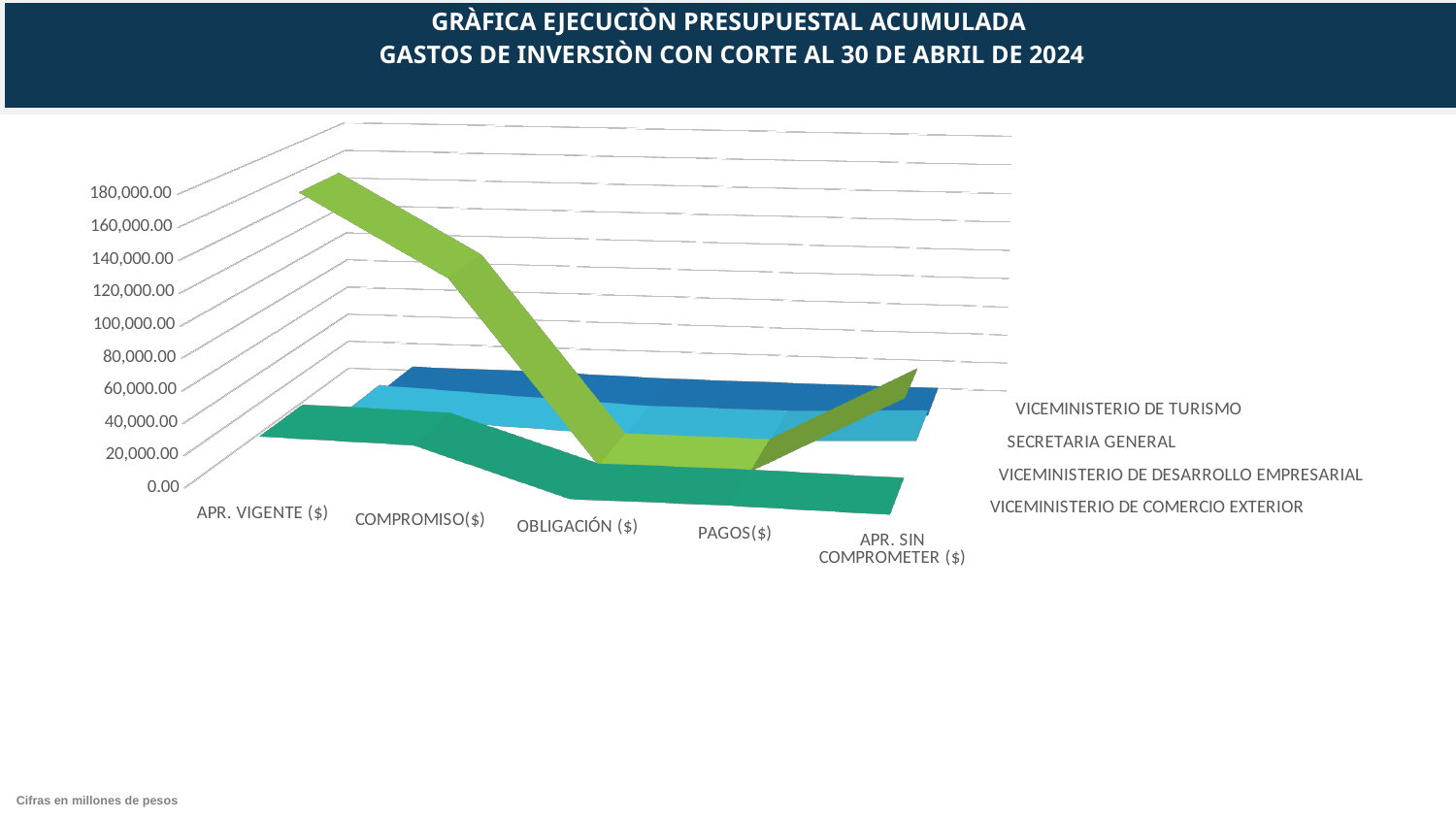
Which category is listed first on the x axis of the chart? APR. VIGENTE ($) Which series has the highest value at APR. VIGENTE ($)? VICEMINISTERIO DE DESARROLLO EMPRESARIAL How many categories are shown along the x axis of the chart? 5 How many series (dependencies) does the chart show? 4 Which series is listed first (frontmost) in the chart's series labels, reading from the bottom? VICEMINISTERIO DE COMERCIO EXTERIOR What is the highest value labelled on the vertical axis of the chart? 180,000.00 Does the VICEMINISTERIO DE DESARROLLO EMPRESARIAL series rise or fall from PAGOS($) to APR. SIN COMPROMETER ($)? rise What kind of chart is shown on the slide? 3D line chart Is the value for VICEMINISTERIO DE DESARROLLO EMPRESARIAL at APR. VIGENTE ($) greater or less than 100,000.00? greater What is the first line of the chart's title? GRÀFICA EJECUCIÒN PRESUPUESTAL ACUMULADA Which category is listed last on the x axis of the chart? APR. SIN COMPROMETER ($) Does the VICEMINISTERIO DE DESARROLLO EMPRESARIAL series rise or fall from APR. VIGENTE ($) to OBLIGACIÓN ($)? fall